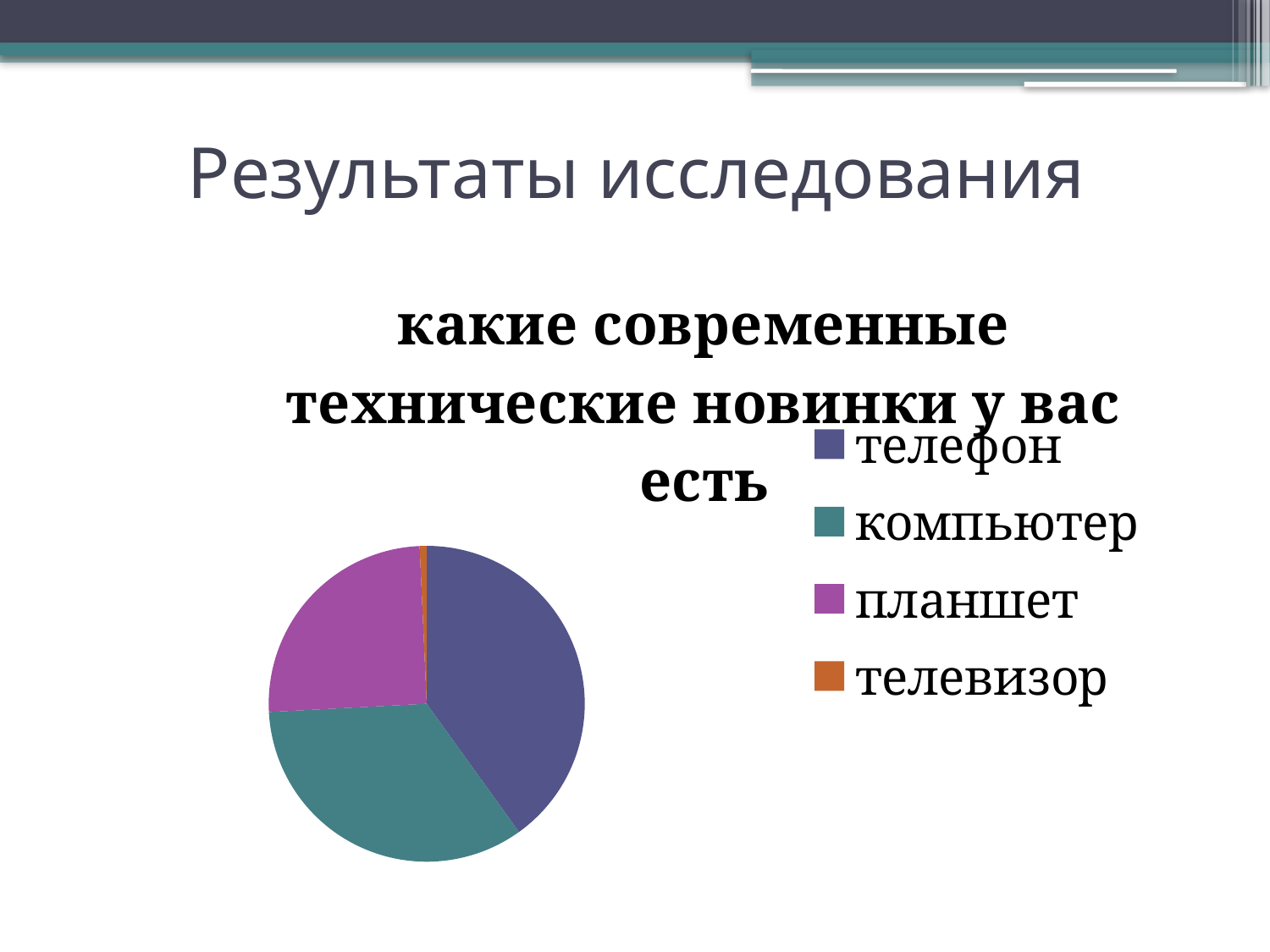
Which category has the smallest slice of the pie chart? телевизор Which category has the largest slice of the pie chart? телефон How many categories does the pie chart show? 4 What kind of chart is shown on the slide? pie chart What is the title of the pie chart? какие современные технические новинки у вас есть Which category is shown in orange in the pie chart legend? телевизор How many entries does the legend of the pie chart list? 4 Which slice is larger in the pie chart, компьютер or планшет? компьютер Which slice is larger in the pie chart, планшет or телевизор? планшет Which slice is larger in the pie chart, телефон or планшет? телефон